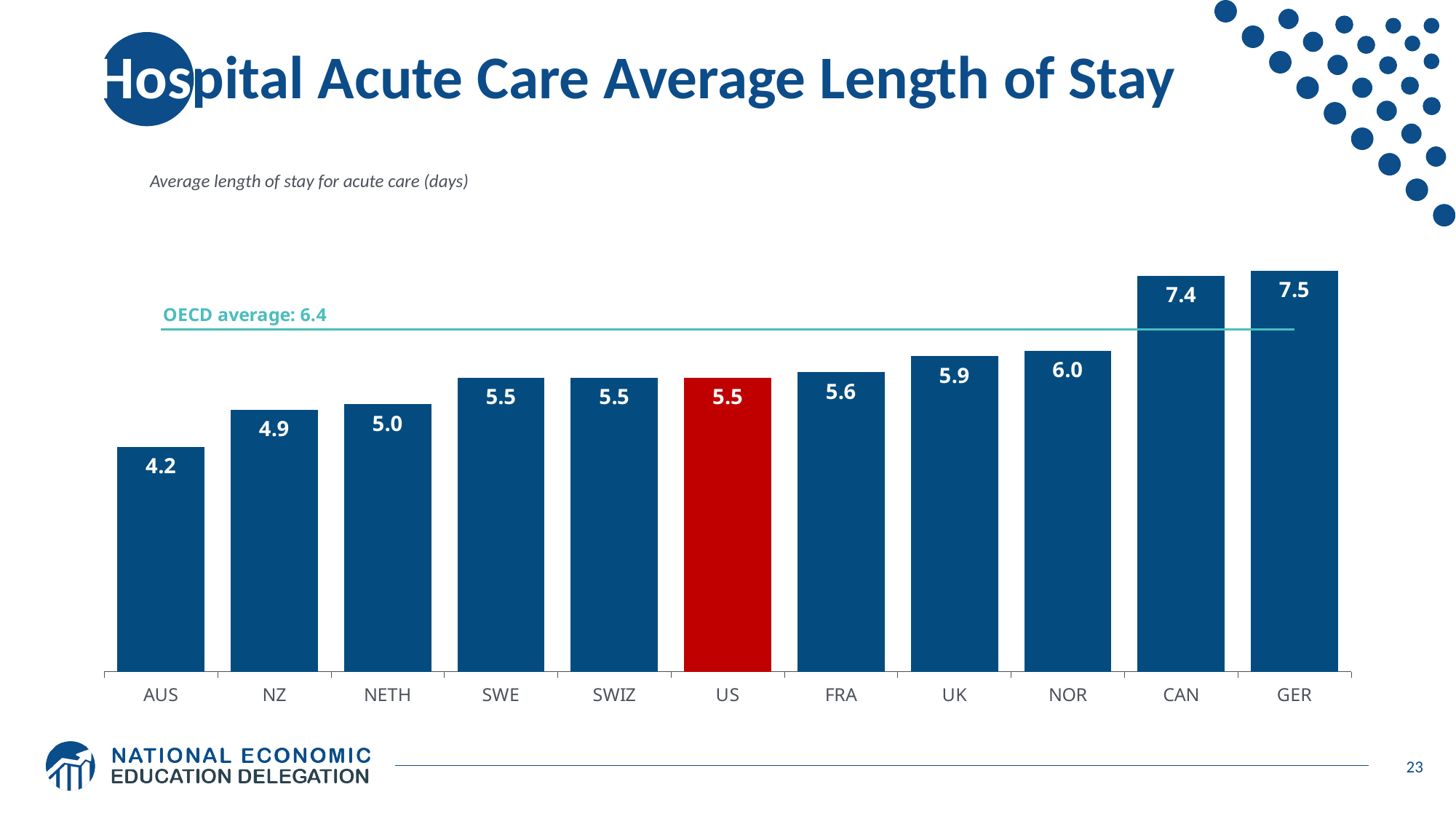
What is the average length of stay for acute care in Germany (GER)? 7.5 What OECD average value is marked by the horizontal line on the chart? 6.4 What is the value shown for AUS? 4.2 What is the average length of stay for acute care in the US? 5.5 What is the difference between the values for GER and AUS? 3.3 What is the difference between the values for CAN and the US? 1.9 How many countries are shown on the chart? 11 Which has a higher average length of stay, UK or NETH? UK Do the values generally rise or fall from left to right across the chart? Rise Which country has the lowest average length of stay? AUS Which country has the highest average length of stay? GER What kind of chart is shown on the slide? Bar chart